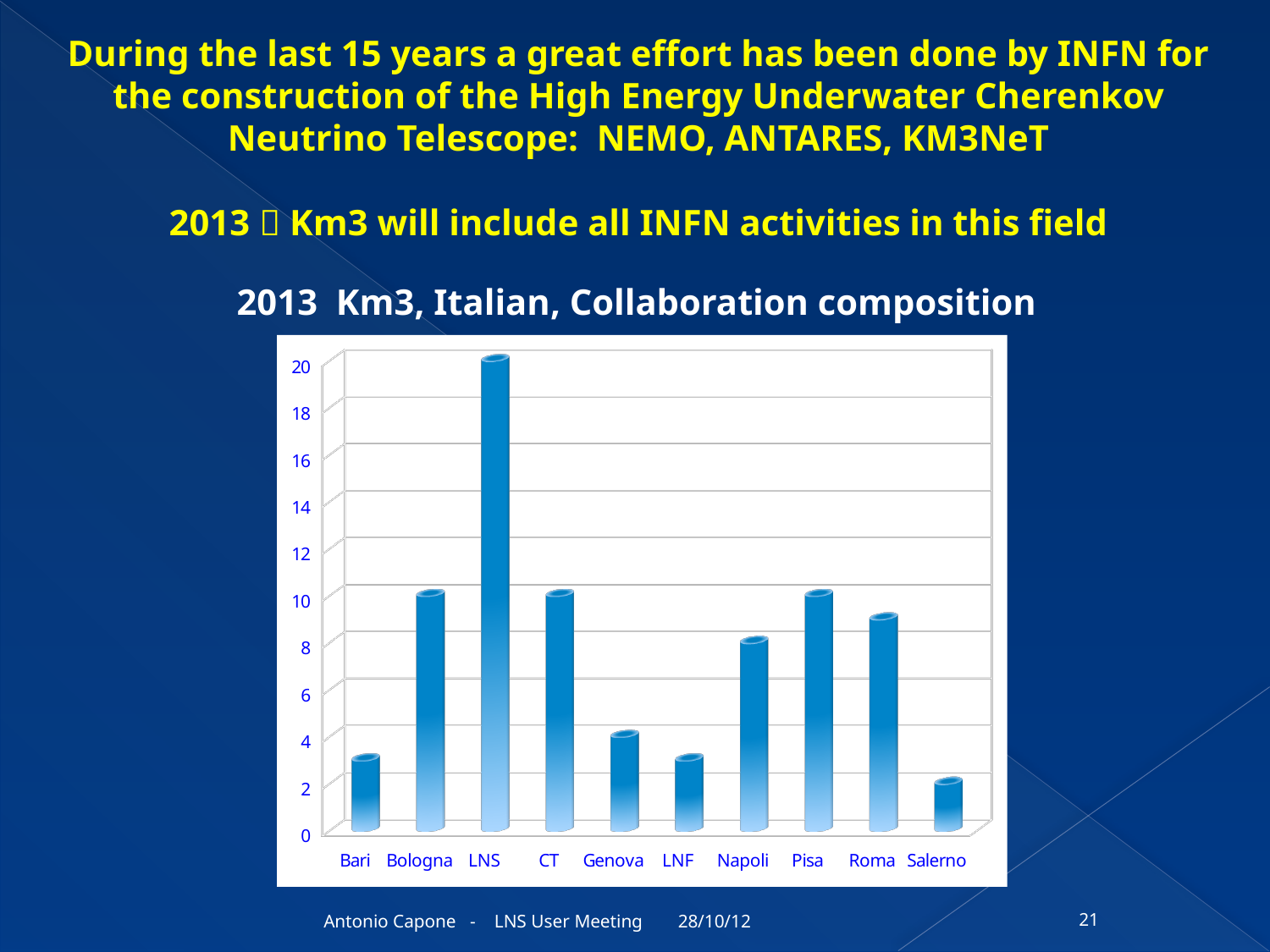
What is the difference between the values for LNS and Pisa? 10 What is the value for Bologna? 10 How many categories (institutions) are shown on the x axis of the chart? 10 What is the value for Genova? 4 Which institution has the lowest value in the chart? Salerno Is the value for Roma greater or less than 8? greater What type of chart is shown on the slide? bar chart What is the title of the chart? 2013 Km3, Italian, Collaboration composition What is the value for LNS? 20 Which institution has the highest value in the chart? LNS Which has a larger value, Napoli or Genova? Napoli What is the value for Napoli? 8